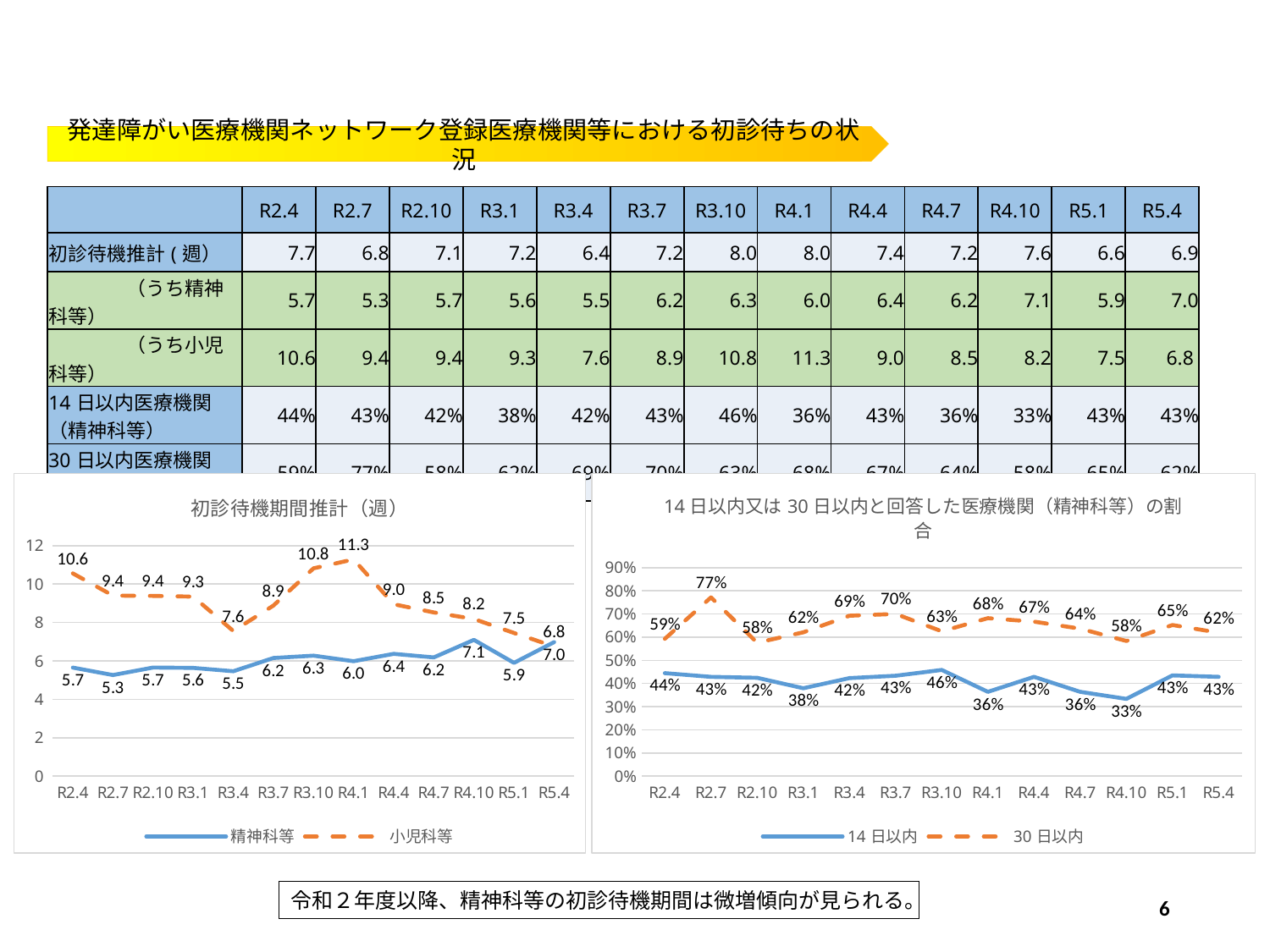
In the right chart, how many periods are shown on the x axis? 13 In the right chart, what is the value for 14日以内 at R4.10? 33% In the left chart titled 初診待機期間推計（週）, what kind of chart is it? Line chart In the left chart titled 初診待機期間推計（週）, what is the value for 小児科等 at R4.1? 11.3 In the left chart titled 初診待機期間推計（週）, what is the difference between 小児科等 and 精神科等 at R2.4? 4.9 In the left chart titled 初診待機期間推計（週）, at which period is the 精神科等 value lowest? R2.7 In the right chart, at which period is the 14日以内 value highest? R3.10 In the right chart, which is larger at R3.1: 14日以内 or 30日以内? 30日以内 In the left chart titled 初診待機期間推計（週）, at which period is the 小児科等 value highest? R4.1 In the right chart, what is the value for 30日以内 at R2.7? 77% In the left chart titled 初診待機期間推計（週）, how many series does the legend list? 2 In the left chart titled 初診待機期間推計（週）, what is the value for 精神科等 at R4.10? 7.1